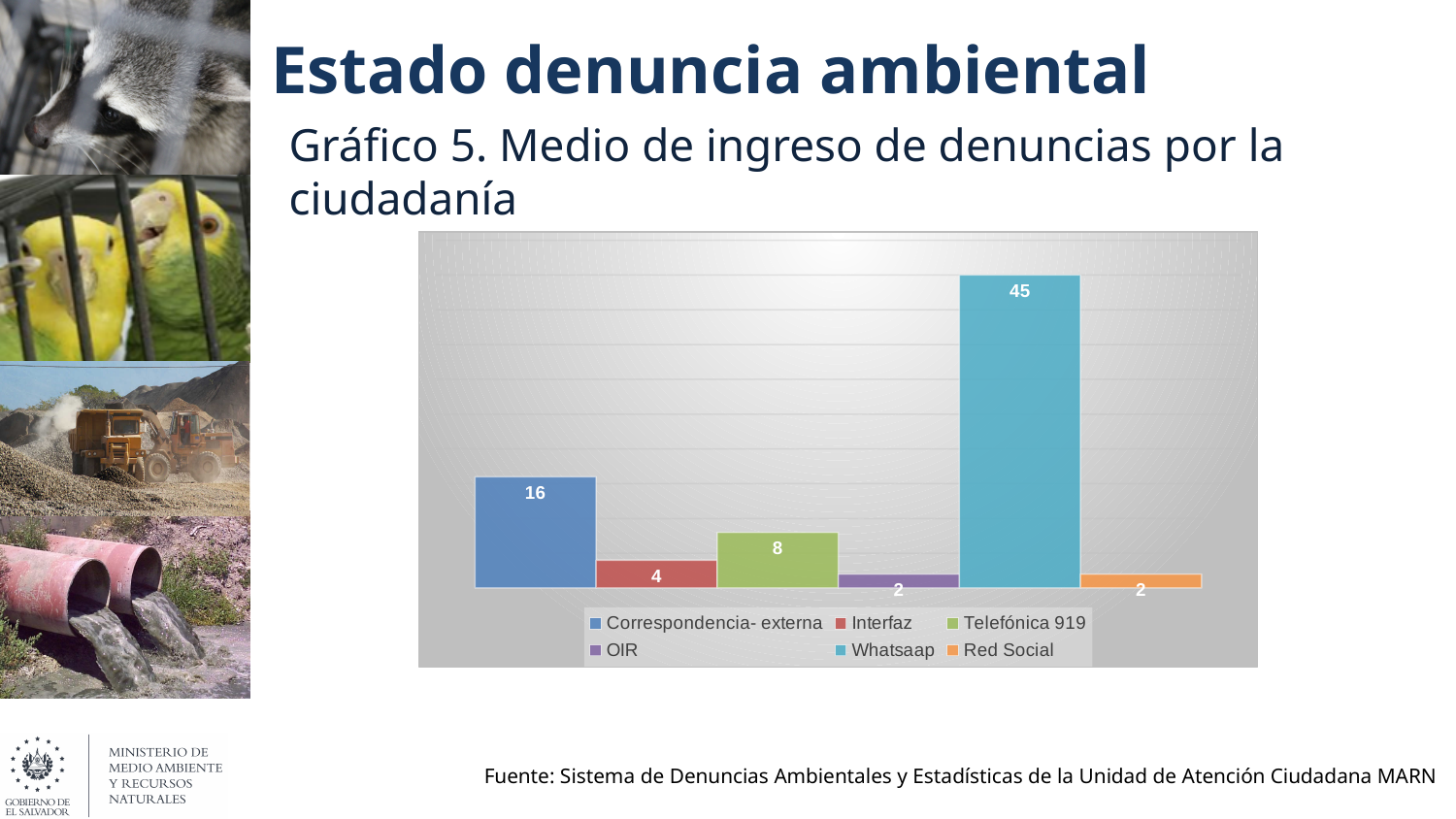
What is the value for Interfaz? 4 What is the title of the chart as given on the slide? Gráfico 5. Medio de ingreso de denuncias por la ciudadanía How many series does the legend list? 6 What is the value for Whatsaap? 45 What is the value for Correspondencia- externa? 16 What is the value for OIR? 2 What is the difference between the values for Telefónica 919 and Interfaz? 4 Which medium has the highest value? Whatsaap Which is larger, the value for Correspondencia- externa or the value for Telefónica 919? Correspondencia- externa What is the value for Telefónica 919? 8 What kind of chart is shown on the slide? bar chart What is the difference between the values for Whatsaap and Correspondencia- externa? 29